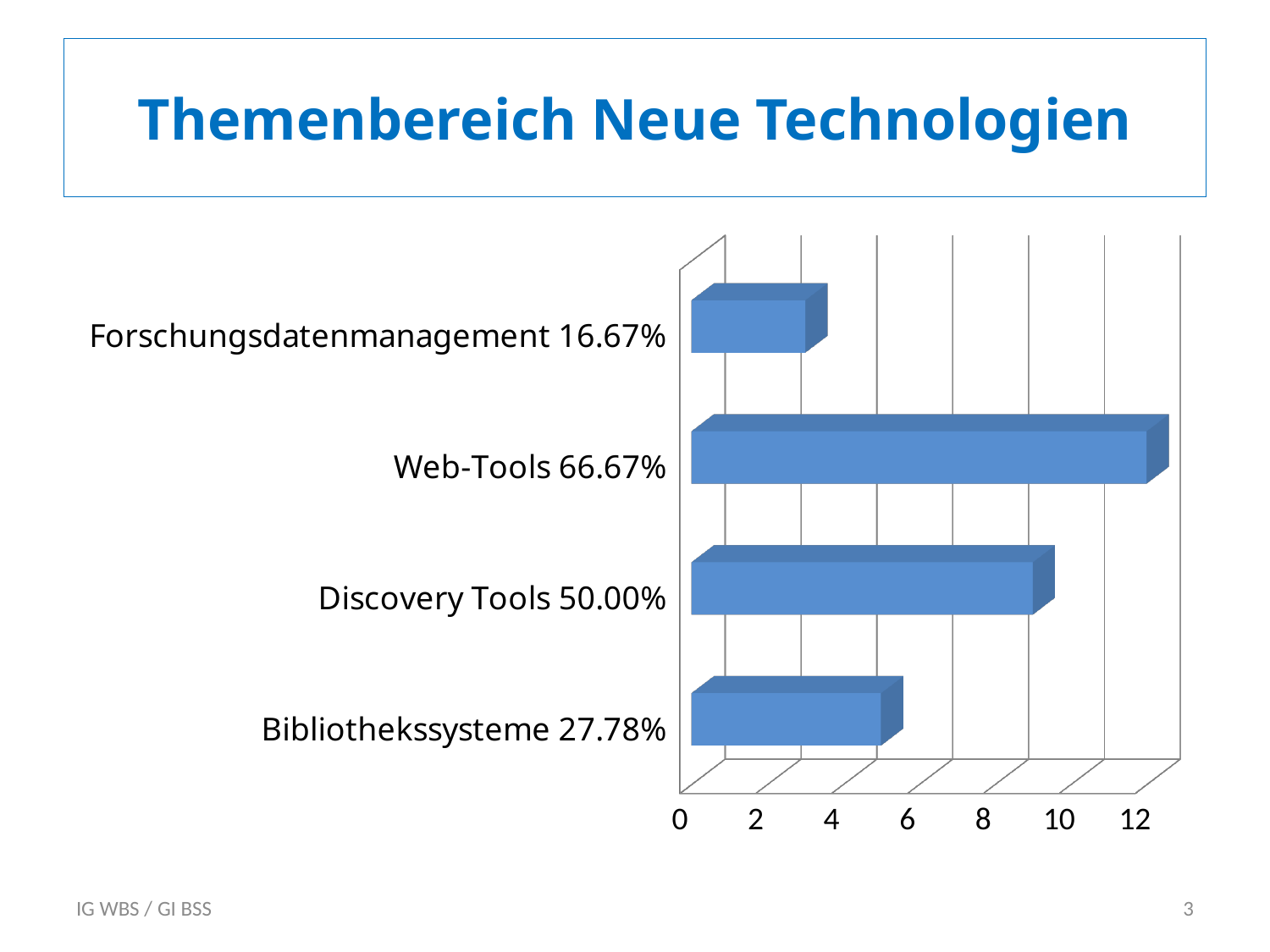
What percentage is printed next to Forschungsdatenmanagement? 16.67% Is the bar for Forschungsdatenmanagement greater or less than 6? less Which category has the longest bar? Web-Tools What kind of chart is shown on the slide? bar chart Which has the longer bar, Discovery Tools or Bibliothekssysteme? Discovery Tools Is the bar for Web-Tools greater or less than 10? greater What is the title of the slide containing the chart? Themenbereich Neue Technologien What percentage is printed next to Bibliothekssysteme? 27.78% What percentage is printed next to Discovery Tools? 50.00% How many categories does the chart show? 4 Which category has the shortest bar? Forschungsdatenmanagement What percentage is printed next to Web-Tools? 66.67%